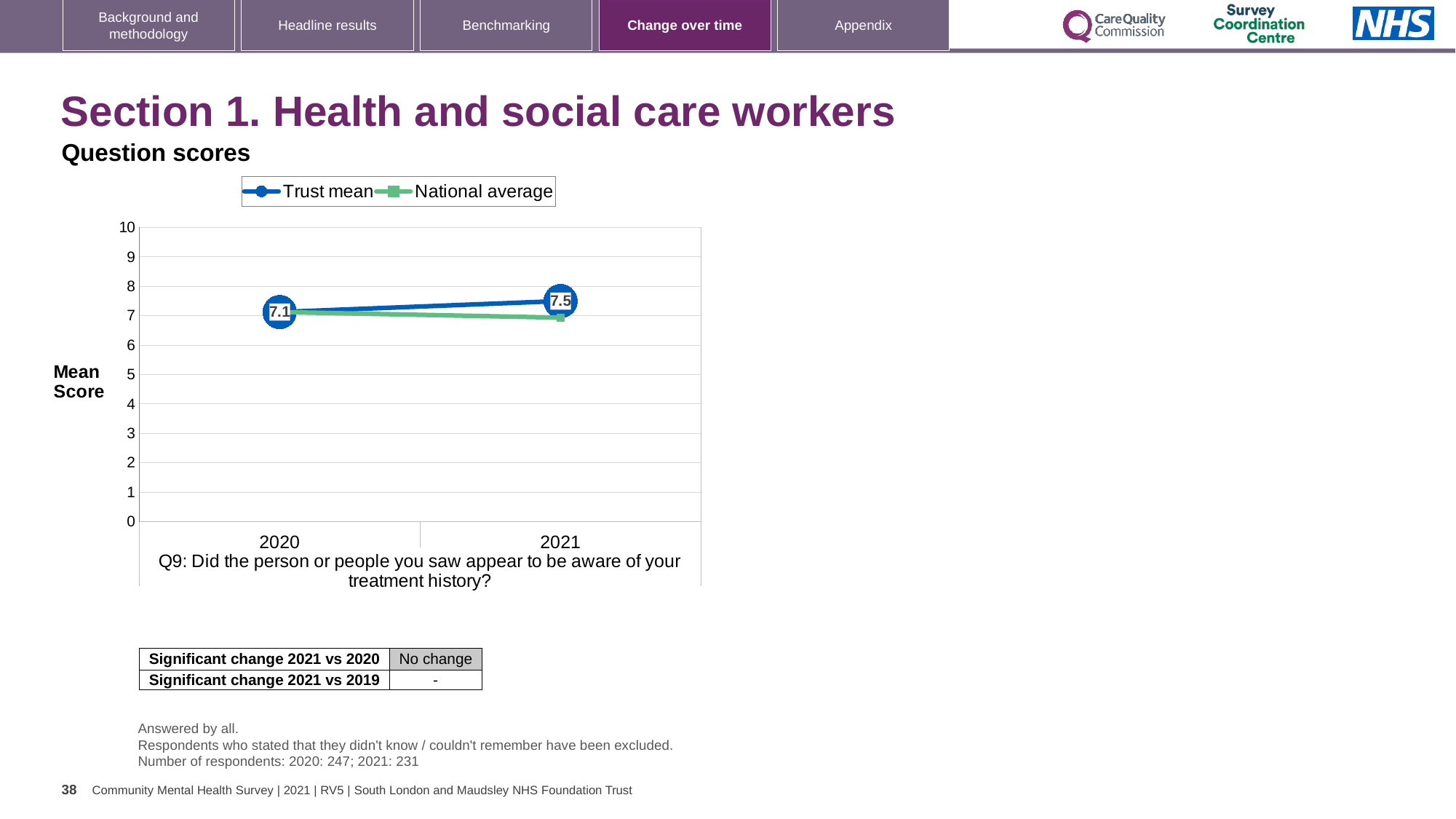
Is the National average for 2021 greater or less than 6? greater By how much did the Trust mean score change from 2020 to 2021? 0.4 What kind of chart is shown on the slide? line chart What is the Trust mean score for 2020? 7.1 Does the Trust mean rise or fall from 2020 to 2021? rise In which year is the Trust mean score lower? 2020 What is the label on the y axis of the chart? Mean Score What is the Trust mean score for 2021? 7.5 In 2021, which is larger: the Trust mean or the National average? Trust mean How many years are plotted on the x axis? 2 In which year is the Trust mean score higher? 2021 How many series does the legend list? 2